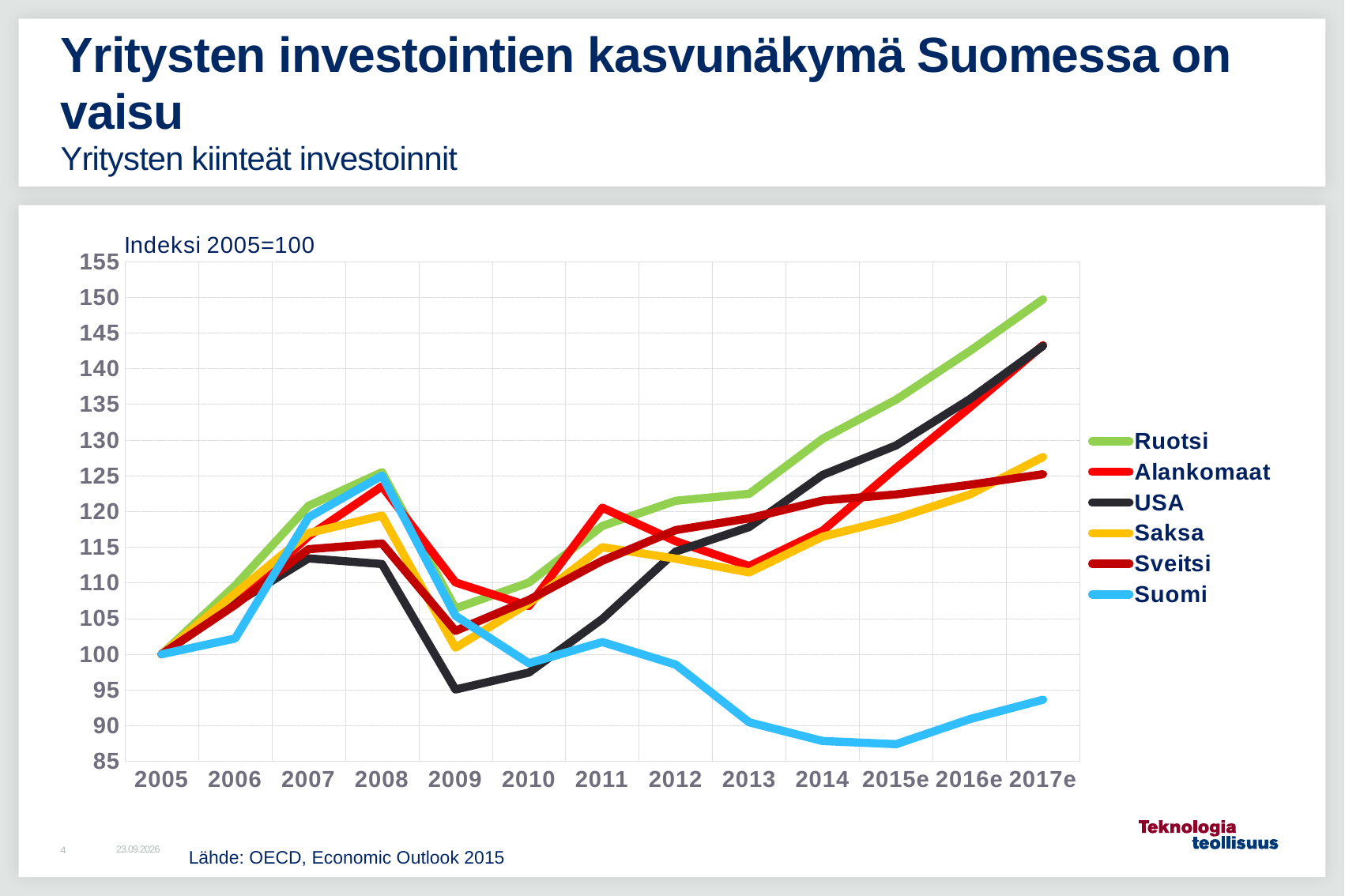
Is the value for Ruotsi in 2017e greater or less than 145? greater What is the index value for Suomi in 2005? 100 Does the line for Suomi rise or fall from 2011 to 2015e? fall How many years are shown on the x axis? 13 What kind of chart is shown on the slide? line chart Which is larger in 2017e, the value for USA or the value for Saksa? USA Which country has the highest value in 2017e? Ruotsi How many series does the legend list? 6 Is the value for Suomi in 2015e greater or less than 90? less Which country has the lowest value in 2017e? Suomi Which country has the lowest value in 2009? USA What base index is stated above the chart? Indeksi 2005=100